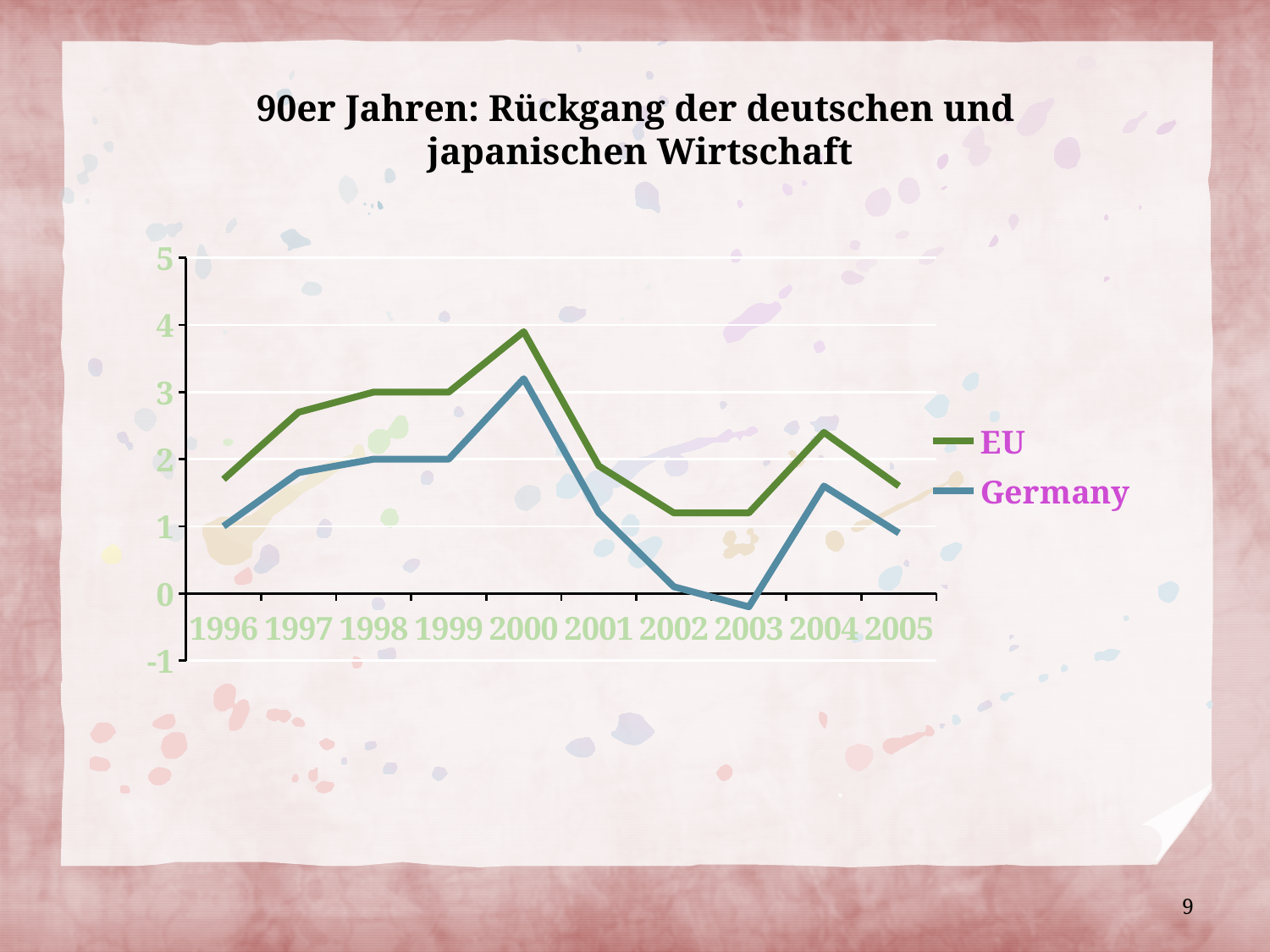
How many years are shown on the x axis? 10 Is the value for Germany in 2003 greater or less than 0? less Is the value for EU in 2000 greater or less than 3? greater Which series has the higher value in 2000, EU or Germany? EU In which year does the Germany series reach its lowest value? 2003 What kind of chart is shown on the slide? line chart Which series is drawn in green? EU Do the values of the Germany series rise or fall from 2000 to 2003? fall In which year does the EU series reach its highest value? 2000 What is the title of the slide containing the chart? 90er Jahren: Rückgang der deutschen und japanischen Wirtschaft How many series does the legend list? 2 Is the value for Germany in 2002 greater or less than 1? less